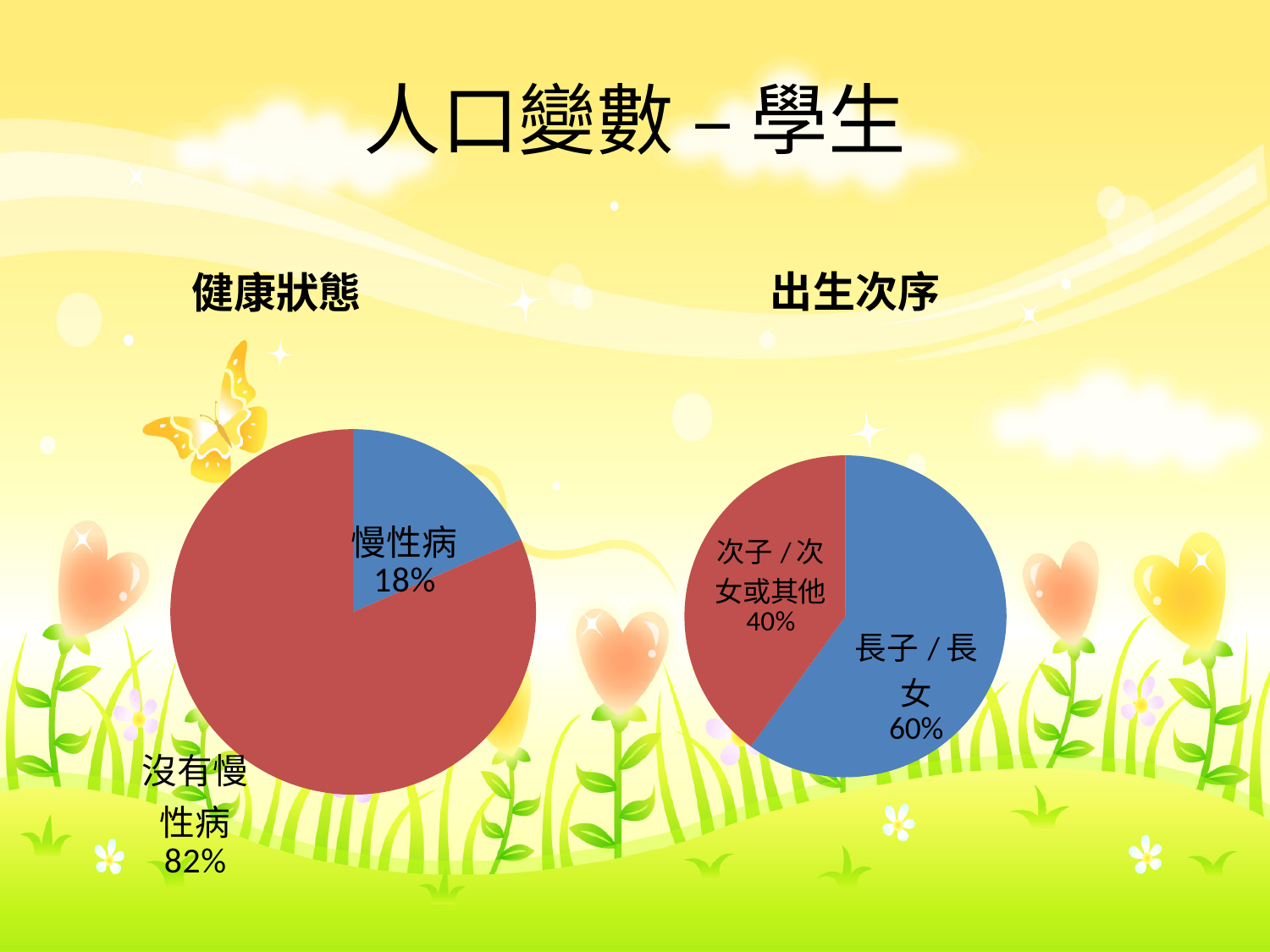
In the 健康狀態 chart, what colour is the 慢性病 slice? Blue In the 健康狀態 chart, what share of students have 沒有慢性病? 82% How many slices does the 出生次序 chart have? 2 In the 出生次序 chart, what share of students are 長子 / 長女? 60% In the 出生次序 chart, what share of students are 次子 / 次女或其他? 40% In the 健康狀態 chart, what is the difference between the 沒有慢性病 and 慢性病 shares? 64% In the 出生次序 chart, what is the difference between the 長子 / 長女 and 次子 / 次女或其他 shares? 20% In the 健康狀態 chart, what share of students have 慢性病? 18% In the 出生次序 chart, which slice is the smallest? 次子 / 次女或其他 What kind of chart is the 健康狀態 chart? Pie chart In the 健康狀態 chart, which slice is the largest? 沒有慢性病 In the 出生次序 chart, which is larger: 長子 / 長女 or 次子 / 次女或其他? 長子 / 長女